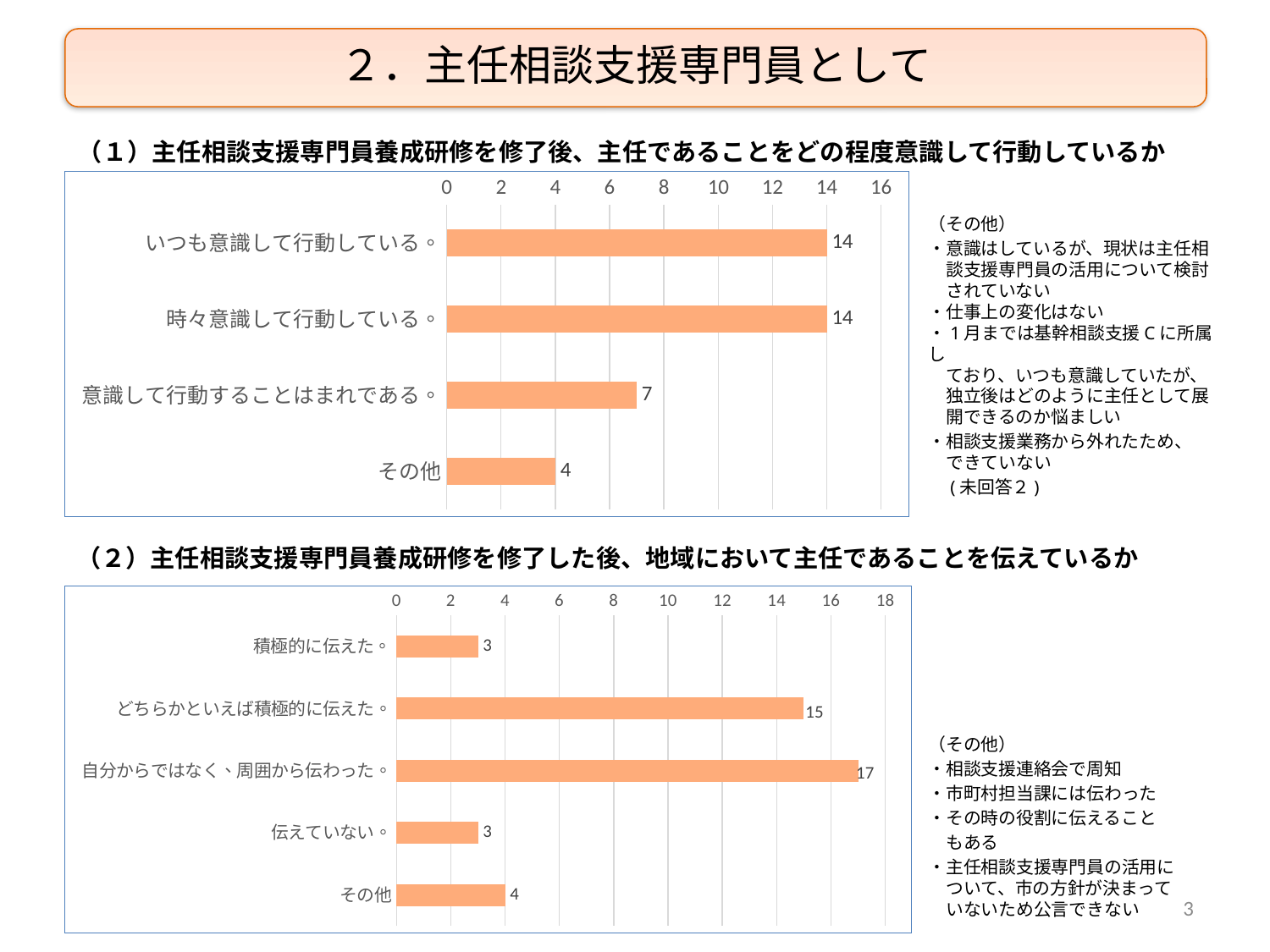
In the bottom chart, which category has the highest value? 自分からではなく、周囲から伝わった。 In the bottom chart, what is the value for どちらかといえば積極的に伝えた。? 15 In the top chart, what is the value for 意識して行動することはまれである。? 7 In the top chart, what is the value for その他? 4 In the top chart, which category has the lowest value? その他 How many categories does the top chart show? 4 In the bottom chart, which is larger, その他 or 伝えていない。? その他 In the top chart, what is the difference between いつも意識して行動している。 and 意識して行動することはまれである。? 7 In the bottom chart, what is the value for 自分からではなく、周囲から伝わった。? 17 What kind of chart is the top chart? Bar chart In the bottom chart, what is the difference between 自分からではなく、周囲から伝わった。 and どちらかといえば積極的に伝えた。? 2 How many categories does the bottom chart show? 5